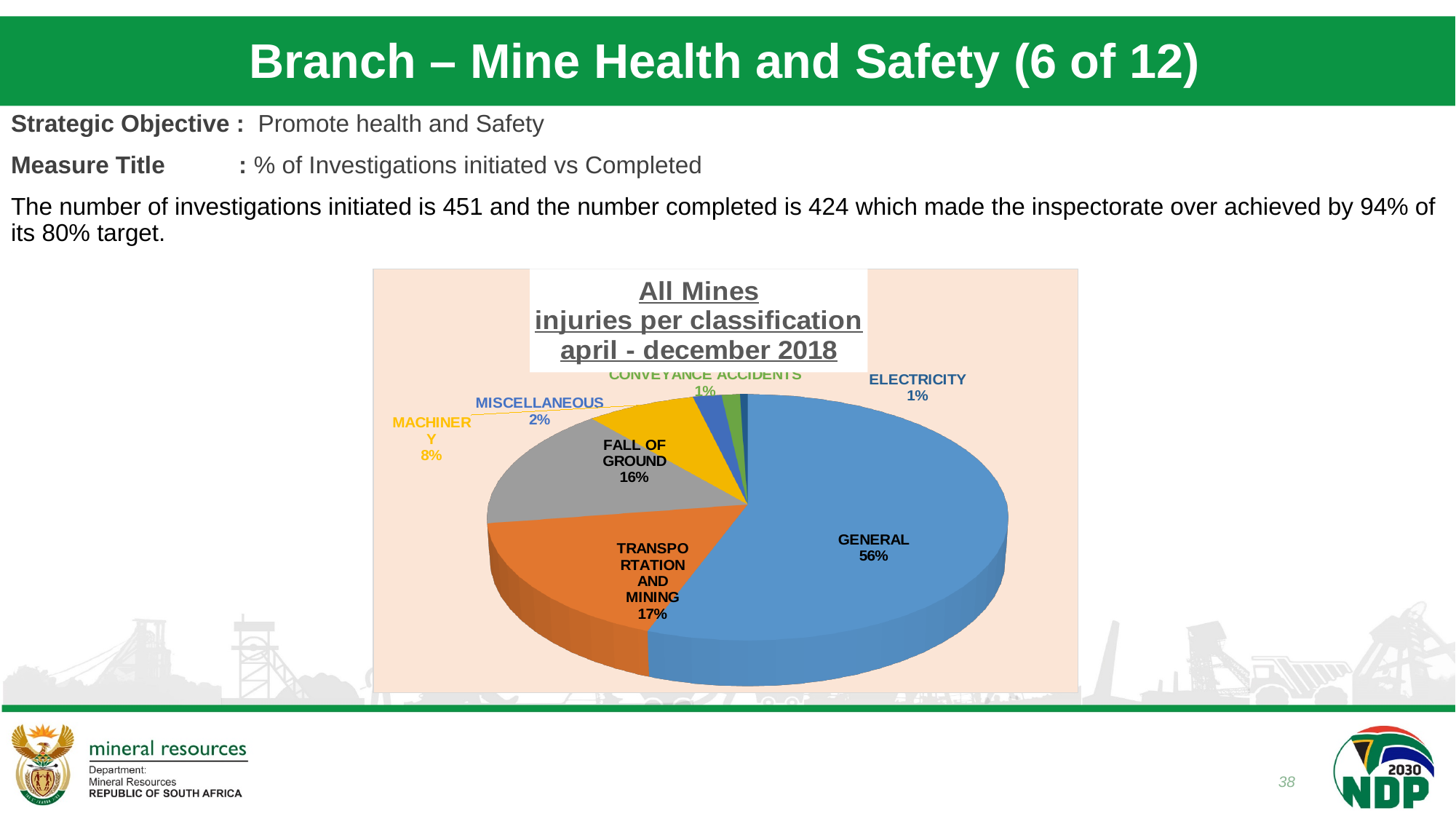
What share of injuries is attributed to MISCELLANEOUS? 2% What share of injuries is attributed to ELECTRICITY? 1% How many injury classifications are shown in the pie chart? 7 What share of injuries is attributed to FALL OF GROUND? 16% Which classification has the largest share of injuries? GENERAL What kind of chart is shown on the slide? Pie chart What share of injuries is attributed to MACHINERY? 8% What is the difference in percentage points between the GENERAL and TRANSPORTATION AND MINING shares? 39 Which has a larger share, FALL OF GROUND or MACHINERY? FALL OF GROUND What is the title of the chart? All Mines injuries per classification april - december 2018 What share of injuries is attributed to GENERAL? 56% What share of injuries is attributed to TRANSPORTATION AND MINING? 17%